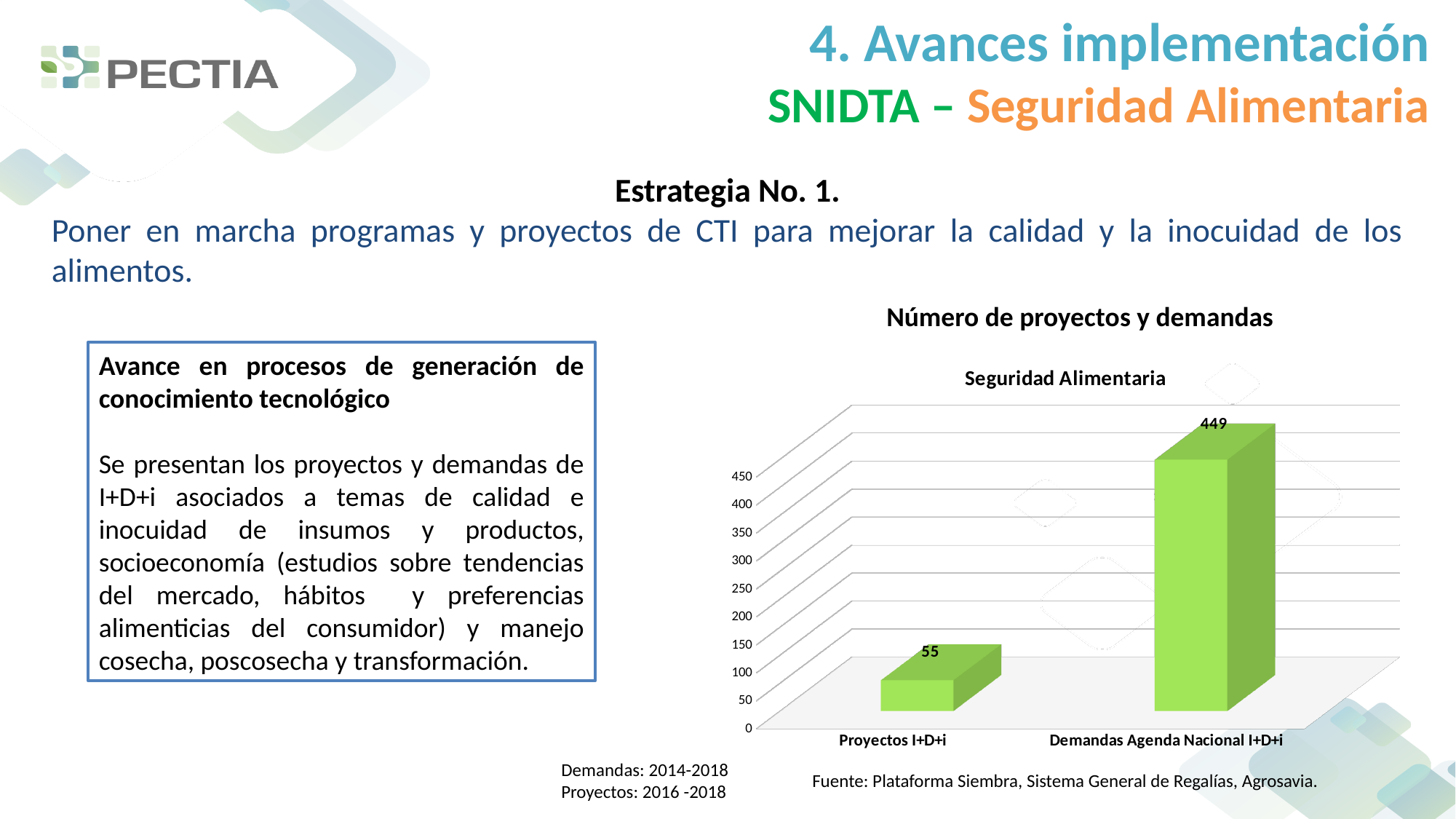
What is the value for Proyectos I+D+i? 55 What kind of chart is shown? bar chart What is the highest value shown on the vertical axis? 450 Which is larger, Proyectos I+D+i or Demandas Agenda Nacional I+D+i? Demandas Agenda Nacional I+D+i What is the difference between Demandas Agenda Nacional I+D+i and Proyectos I+D+i? 394 Is the value for Demandas Agenda Nacional I+D+i greater or less than 400? greater Which category has the highest value? Demandas Agenda Nacional I+D+i Is the value for Proyectos I+D+i greater or less than 100? less What is the value for Demandas Agenda Nacional I+D+i? 449 How many categories are shown in the chart? 2 Which category has the lowest value? Proyectos I+D+i What is the title shown above the chart's plot area? Seguridad Alimentaria